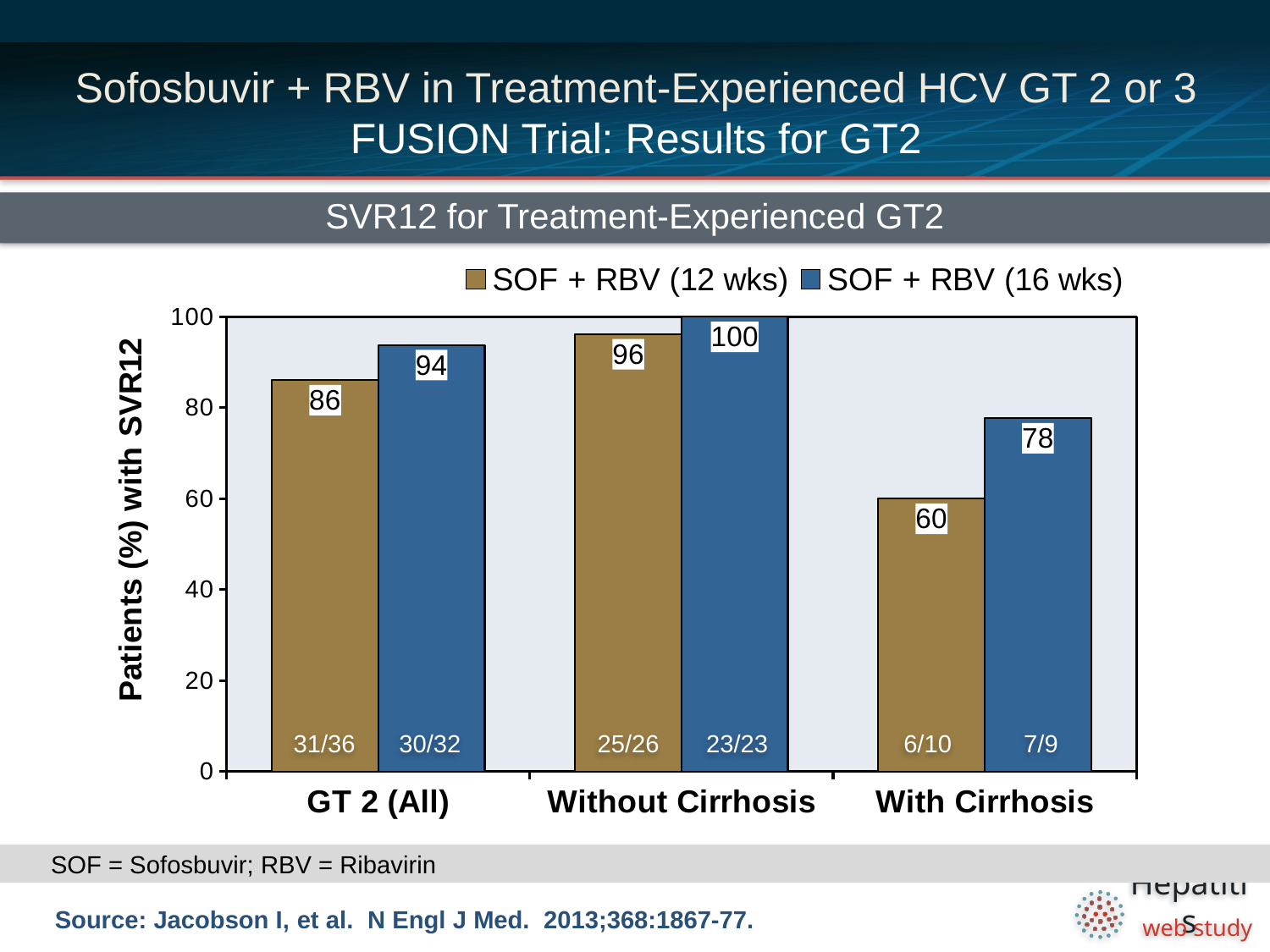
What is the difference between the SOF + RBV (16 wks) and SOF + RBV (12 wks) values in the GT 2 (All) group? 8 In the Without Cirrhosis group, which series has the larger SVR12 value, SOF + RBV (12 wks) or SOF + RBV (16 wks)? SOF + RBV (16 wks) How many categories are shown on the x axis? 3 How many series does the legend list? 2 Which category has the lowest SVR12 value for SOF + RBV (12 wks)? With Cirrhosis Which category has the highest SVR12 value for SOF + RBV (16 wks)? Without Cirrhosis What is the SVR12 value for SOF + RBV (12 wks) in the GT 2 (All) group? 86 What is the SVR12 value for SOF + RBV (16 wks) in the Without Cirrhosis group? 100 What is the difference between the SOF + RBV (16 wks) and SOF + RBV (12 wks) values in the With Cirrhosis group? 18 What is the title of the chart? SVR12 for Treatment-Experienced GT2 What kind of chart is shown on the slide? Bar chart What is the SVR12 value for SOF + RBV (16 wks) in the With Cirrhosis group? 78